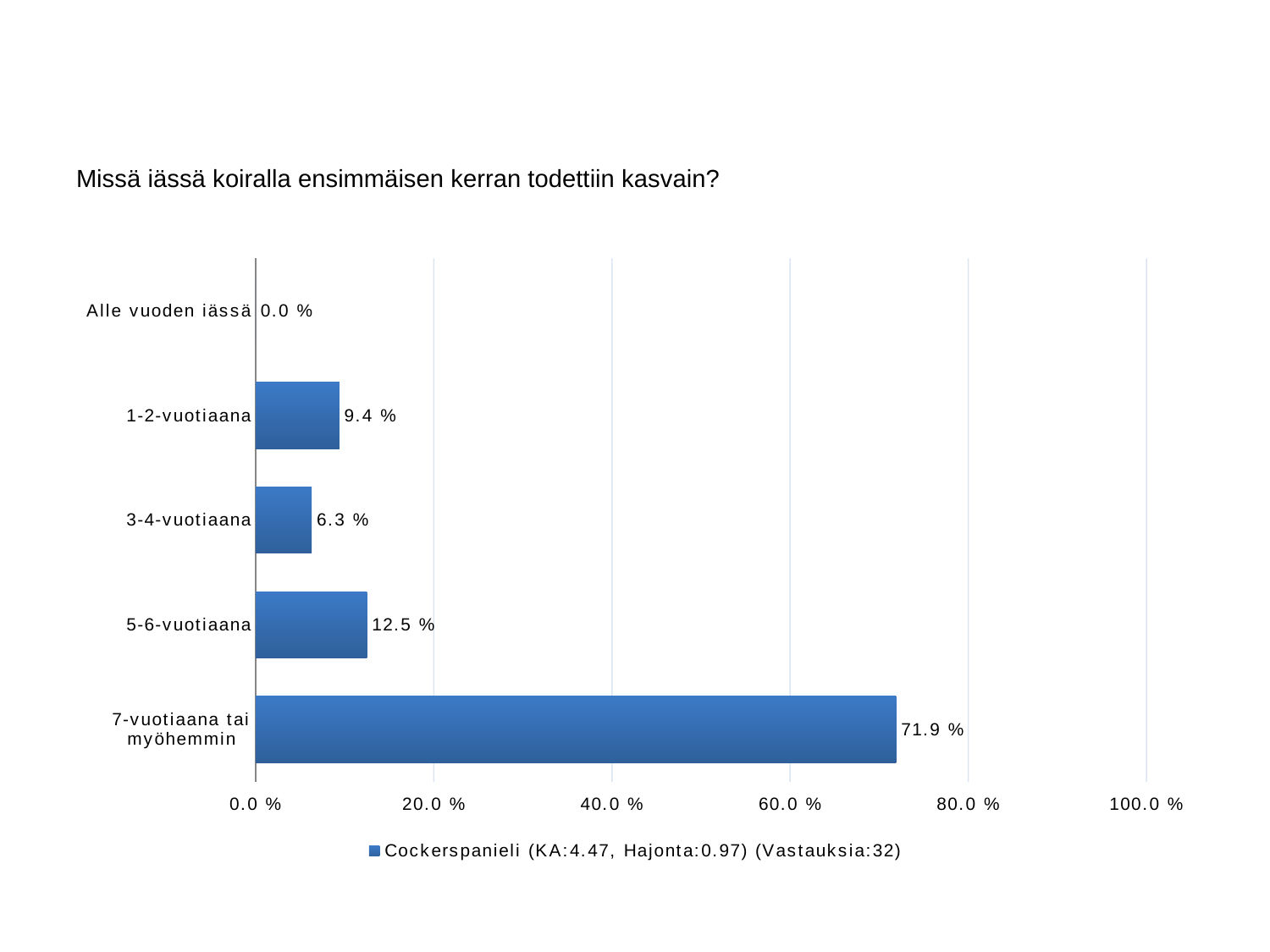
What kind of chart is shown on the slide? bar chart What is the difference between the values for 5-6-vuotiaana and 1-2-vuotiaana? 3.1 % What is the value for 1-2-vuotiaana? 9.4 % What is the value for Alle vuoden iässä? 0.0 % How many series does the legend list? 1 Is the value for 7-vuotiaana tai myöhemmin greater or less than 60.0 %? greater Which category has the highest value? 7-vuotiaana tai myöhemmin How many categories are shown on the chart? 5 Which category has the lowest value? Alle vuoden iässä What is the value for 3-4-vuotiaana? 6.3 % What is the value for 7-vuotiaana tai myöhemmin? 71.9 % Which is larger, the value for 5-6-vuotiaana or the value for 3-4-vuotiaana? 5-6-vuotiaana